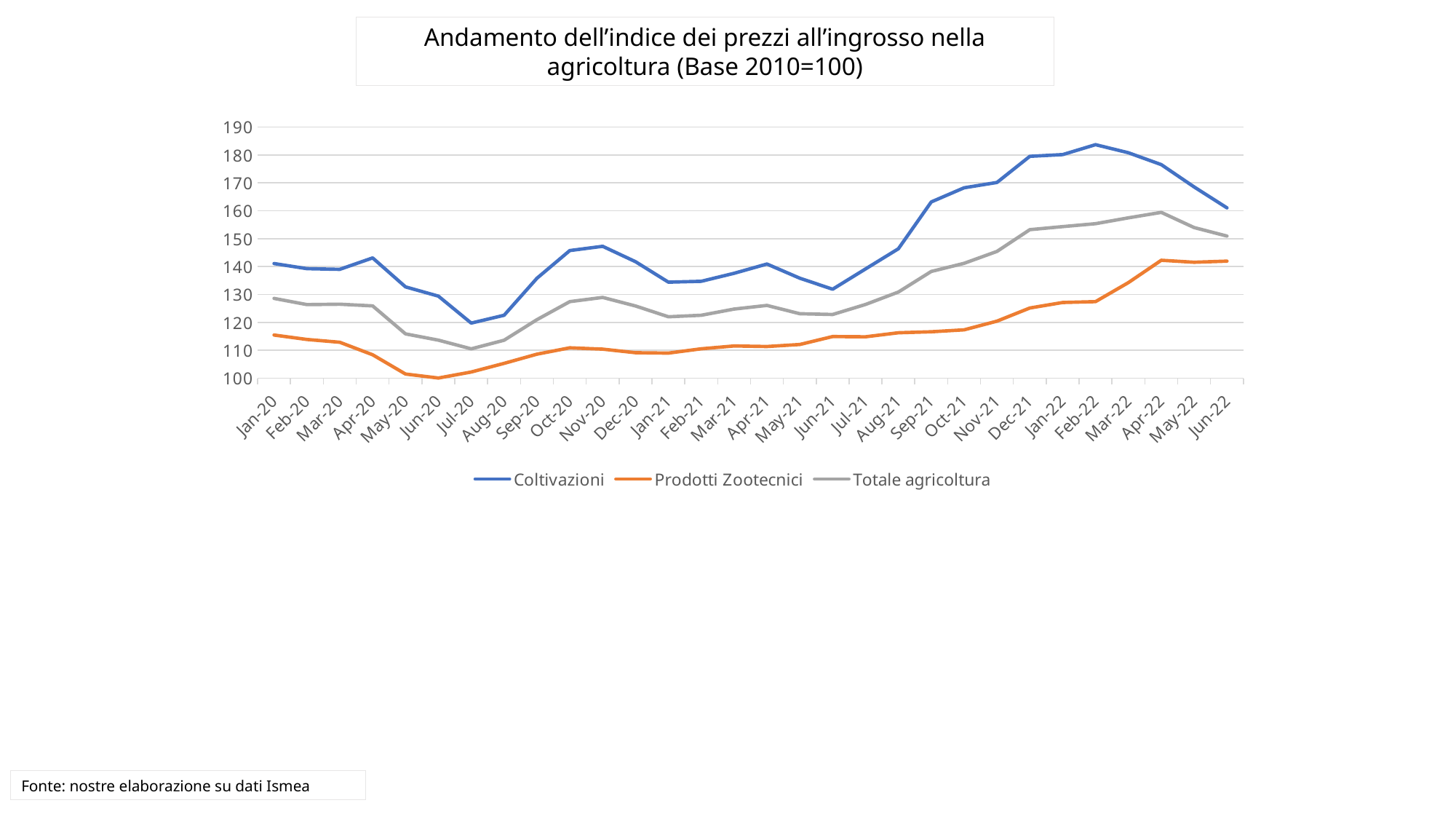
Does the Coltivazioni series rise or fall between Feb-22 and Jun-22? Fall Is the value for Prodotti Zootecnici in Jan-20 greater or less than 110? greater What kind of chart is shown on the slide? Line chart In Jun-22, which series has the higher value: Coltivazioni or Prodotti Zootecnici? Coltivazioni How many series does the legend list? 3 In which month does the Coltivazioni series reach its highest value? Feb-22 In which month does the Totale agricoltura series reach its highest value? Apr-22 In which month does the Prodotti Zootecnici series reach its lowest value? Jun-20 Is the value for Totale agricoltura in Jul-20 greater or less than 120? less Which colour is used for the Prodotti Zootecnici line? Orange How many monthly data points are plotted along the x axis? 30 Is the value for Coltivazioni in Feb-22 greater or less than 180? greater